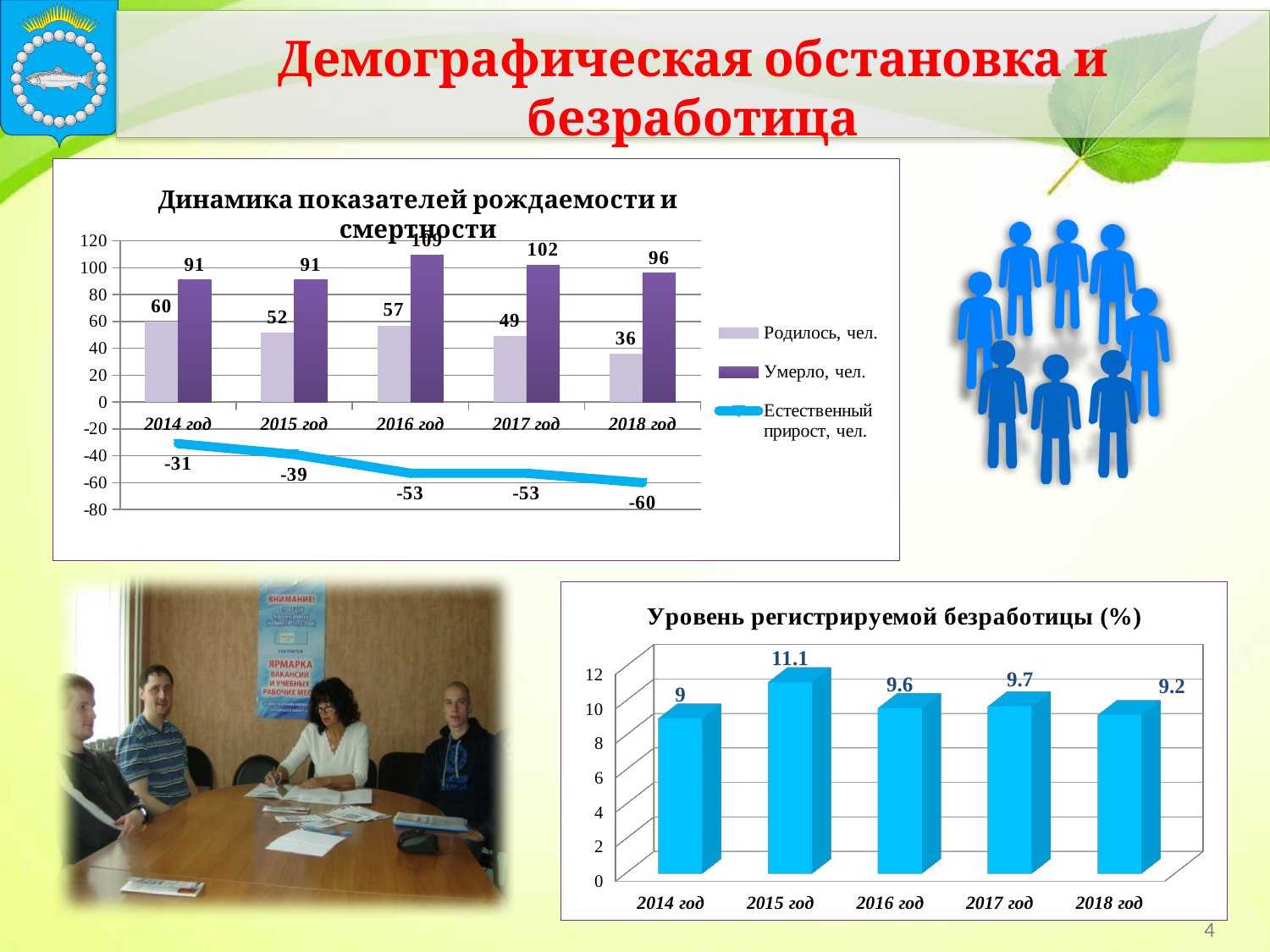
In the chart 'Уровень регистрируемой безработицы (%)', how many years are shown on the x axis? 5 In the chart 'Динамика показателей рождаемости и смертности', what is the value of 'Умерло, чел.' for 2017 год? 102 In the chart 'Динамика показателей рождаемости и смертности', which year has the highest value for 'Умерло, чел.'? 2016 год In the chart 'Динамика показателей рождаемости и смертности', what is the difference between 'Умерло, чел.' and 'Родилось, чел.' in 2014 год? 31 In the chart 'Динамика показателей рождаемости и смертности', does the 'Естественный прирост, чел.' line rise or fall from 2014 год to 2018 год? fall In the chart 'Динамика показателей рождаемости и смертности', which year has the lowest value for 'Родилось, чел.'? 2018 год In the chart 'Динамика показателей рождаемости и смертности', what is the value of 'Родилось, чел.' for 2016 год? 57 In the chart 'Уровень регистрируемой безработицы (%)', what is the difference between the values for 2015 год and 2018 год? 1.9 In the chart 'Динамика показателей рождаемости и смертности', how many series does the legend list? 3 In the chart 'Динамика показателей рождаемости и смертности', what is the value of 'Естественный прирост, чел.' for 2018 год? -60 In the chart 'Уровень регистрируемой безработицы (%)', what is the value for 2015 год? 11.1 In the chart 'Уровень регистрируемой безработицы (%)', which year has the lowest value? 2014 год